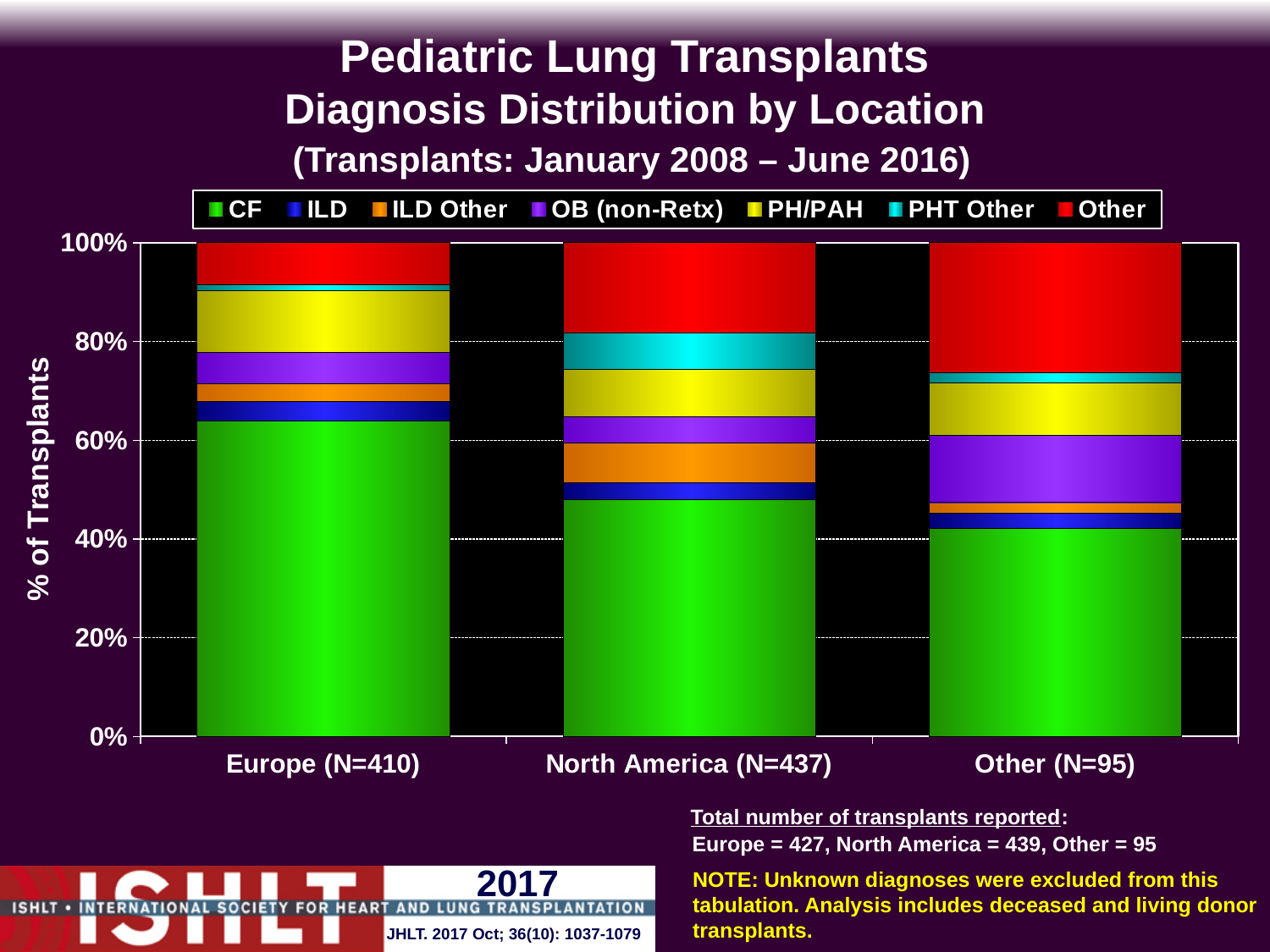
What is the N shown for North America in the category label? 437 How many locations (categories) are shown on the x axis? 3 Which location has the smallest CF share of transplants? Other (N=95) Does the CF share rise or fall moving from Europe to North America to Other along the x axis? Fall Is the CF share for Europe greater or less than 60%? greater How many diagnosis series does the legend list? 7 Which has a larger 'Other' diagnosis share: Europe or the Other location? Other (N=95) Is the 'Other' diagnosis share for the Other location greater or less than 20%? greater Which location has the largest CF share of transplants? Europe (N=410) Is the 'Other' diagnosis share for Europe greater or less than 20%? less What kind of chart is shown on the slide? Stacked bar chart